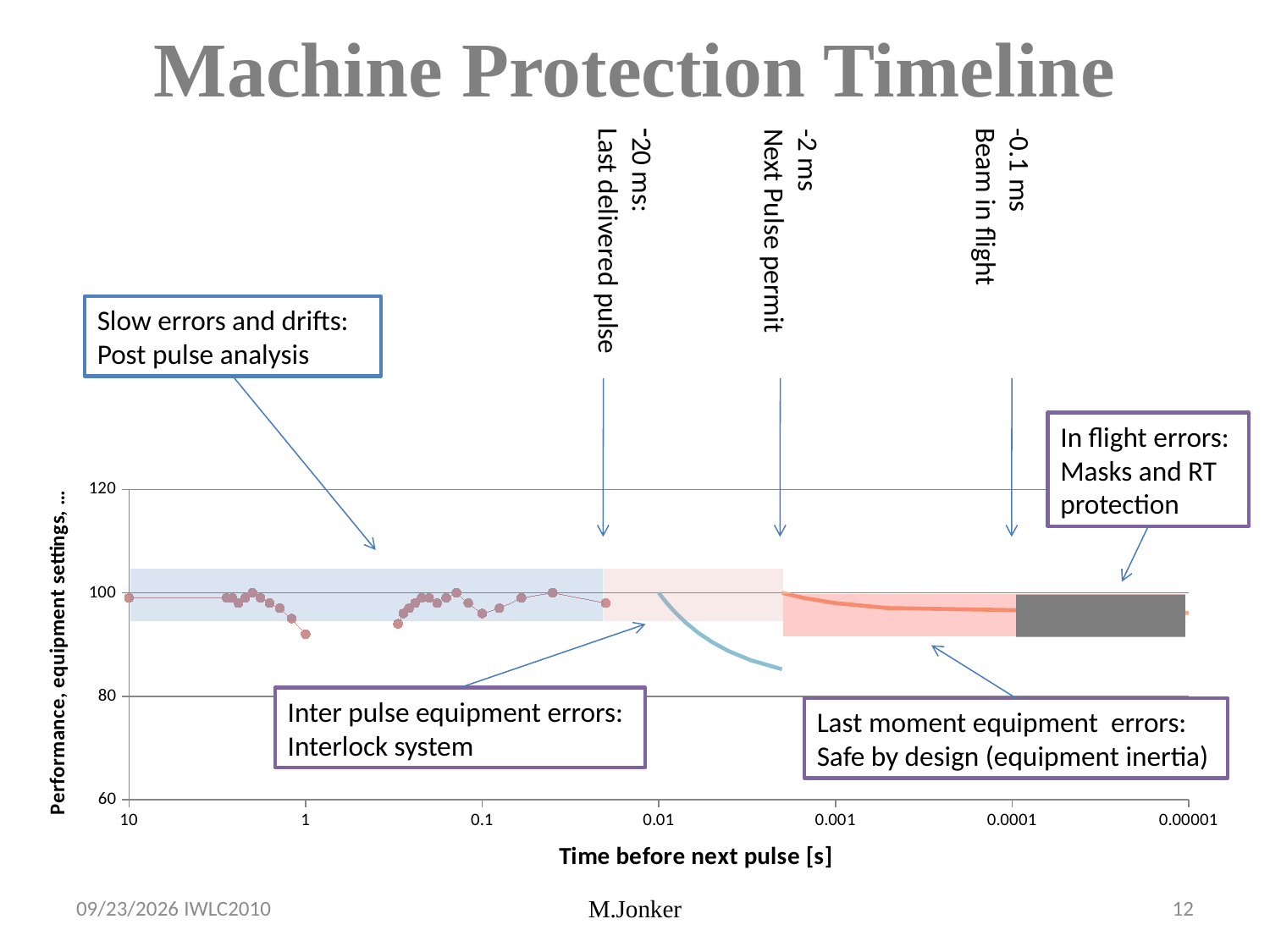
What is the highest value shown on the y axis? 120 How many tick labels are shown on the x axis? 7 What kind of chart is shown on the slide? line chart Is the lowest point of the blue curve (between 0.01 and 0.001) greater or less than 80? greater What is the rightmost tick label on the x axis? 0.00001 How many tick labels are shown on the y axis? 4 Is the lowest dotted data point (near x = 1) greater or less than 80? greater What is the lowest value shown on the y axis? 60 What is the leftmost tick label on the x axis? 10 What is the title of the x axis of the chart? Time before next pulse [s] What is the title of the y axis of the chart? Performance, equipment settings, ... Does the blue curve rise or fall as it moves from 0.01 toward 0.001 on the x axis? fall